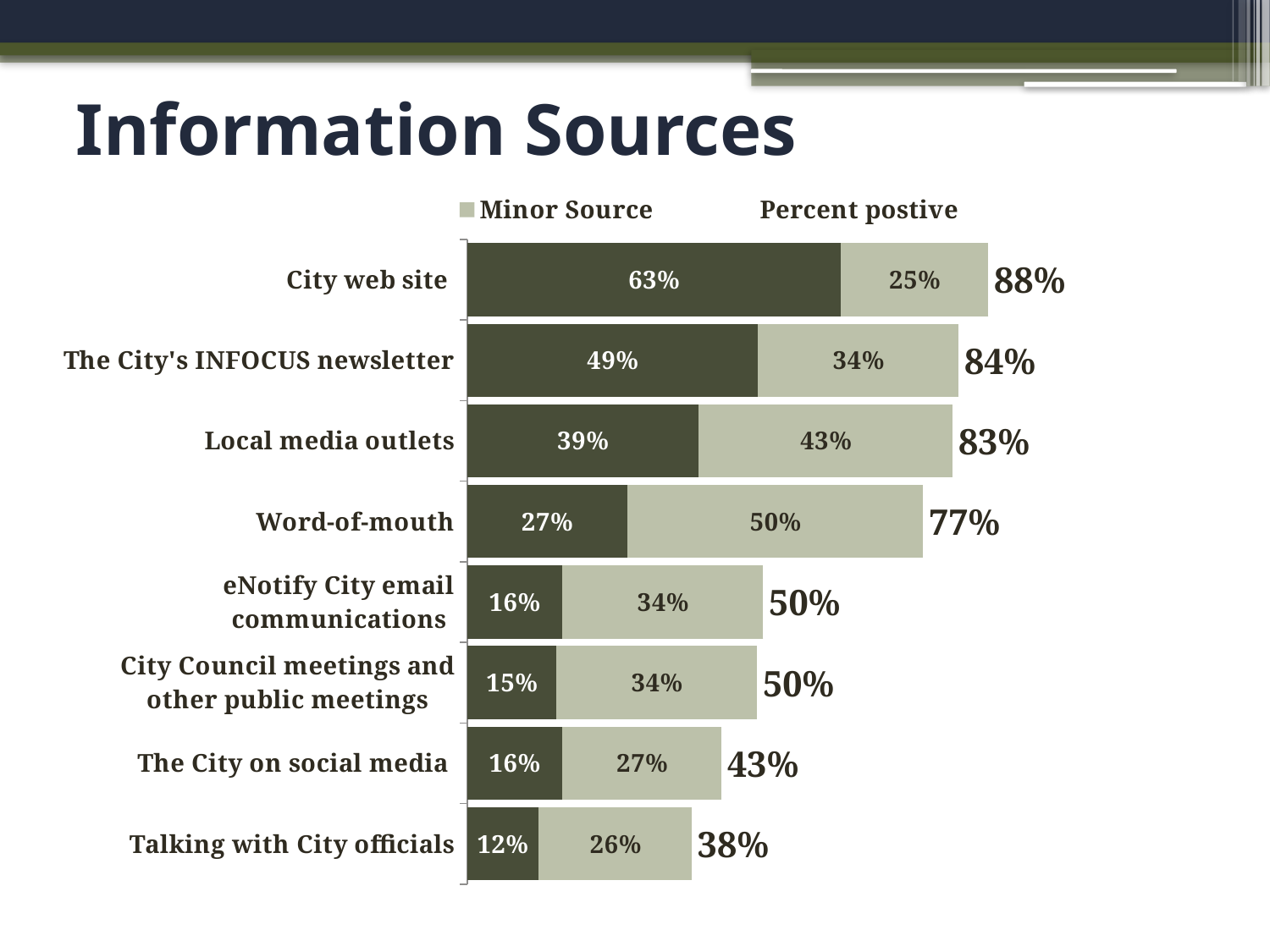
Which information source has the highest Minor Source value? Word-of-mouth What is the title of the slide? Information Sources Which information source has the lowest total percent positive? Talking with City officials What is the difference between the Minor Source values for Local media outlets and City web site? 18% What is the difference between the total percent positive for City web site and for Talking with City officials? 50% What is the Minor Source value for Local media outlets? 43% How many information sources (categories) are listed on the chart? 8 Which has the larger Minor Source value, Word-of-mouth or City web site? Word-of-mouth What is the total percent positive shown for City web site? 88% What kind of chart is shown on the slide? bar chart What is the value of the dark green segment for The City's INFOCUS newsletter? 49% Which information source has the highest total percent positive? City web site